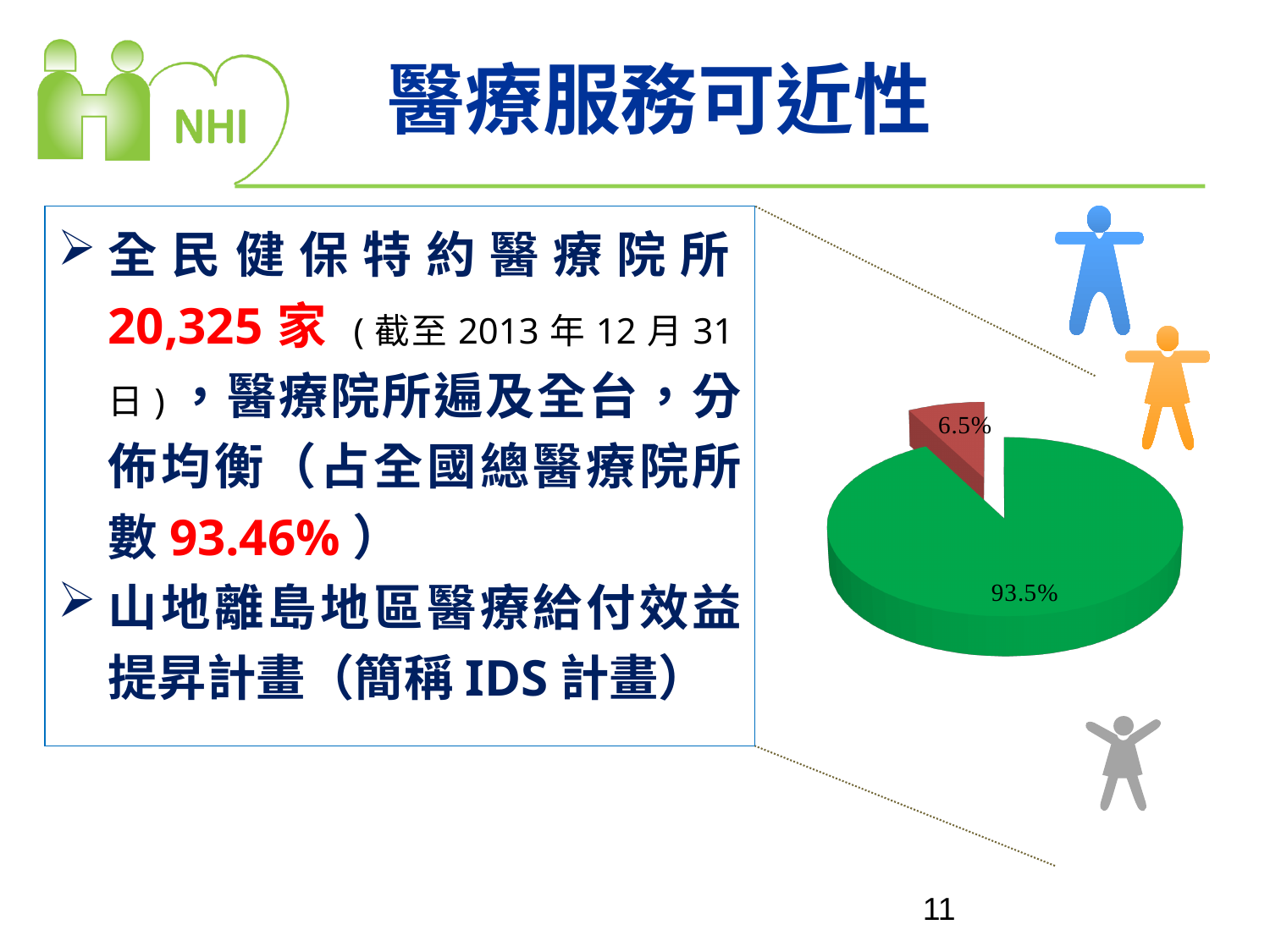
How many slices does the pie chart have? 2 What kind of chart is shown on the right side of the slide? pie chart Which slice of the pie chart is the largest? the green slice (93.5%) Is the pie chart drawn in 3D or flat 2D? 3D What percentage is shown on the green slice of the pie chart? 93.5% What percentage is shown on the red slice of the pie chart? 6.5% Which slice of the pie chart is the smallest? the red slice (6.5%) What colour is the slice labelled 6.5% in the pie chart? red Which is larger in the pie chart, the green slice or the red slice? the green slice What do the two labelled slices of the pie chart add up to? 100% What is the difference in percentage points between the green slice and the red slice of the pie chart? 87